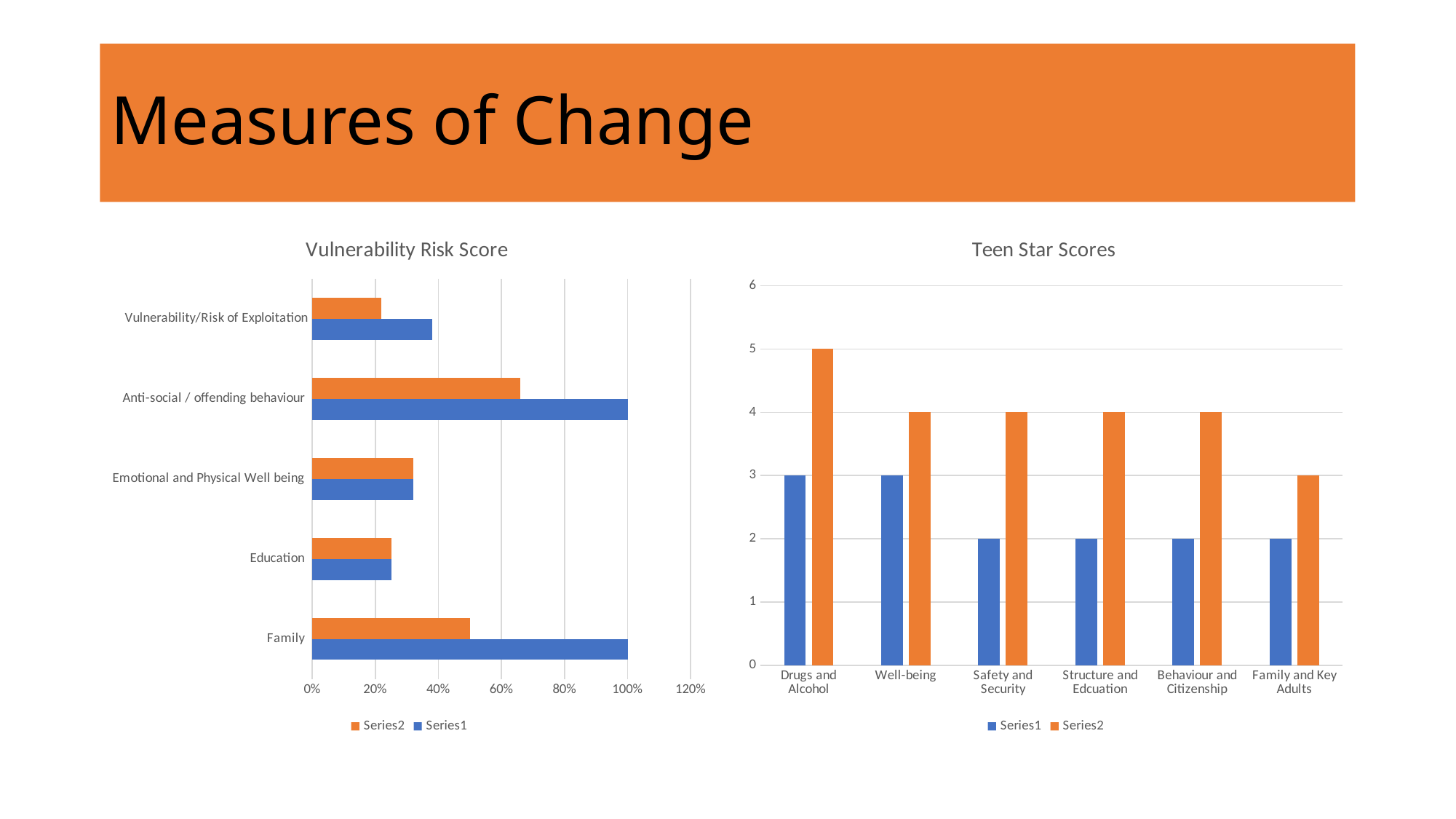
How many categories are shown in the Vulnerability Risk Score chart? 5 In the Vulnerability Risk Score chart, is the Series2 value for Anti-social / offending behaviour greater or less than 60%? greater In the Teen Star Scores chart, what is the Series1 value for Safety and Security? 2 How many series does the legend of the Teen Star Scores chart list? 2 In the Teen Star Scores chart, which category has the highest Series2 value? Drugs and Alcohol In the Vulnerability Risk Score chart, is the Series2 value for Vulnerability/Risk of Exploitation greater or less than 40%? less In the Vulnerability Risk Score chart, what is the Series1 value for Family? 100% In the Teen Star Scores chart, what is the difference between the Series2 and Series1 values for Well-being? 1 What kind of chart is the Vulnerability Risk Score chart? bar chart In the Vulnerability Risk Score chart, which is larger for Family: Series1 or Series2? Series1 How many categories are shown on the x axis of the Teen Star Scores chart? 6 In the Teen Star Scores chart, what is the Series2 value for Drugs and Alcohol? 5